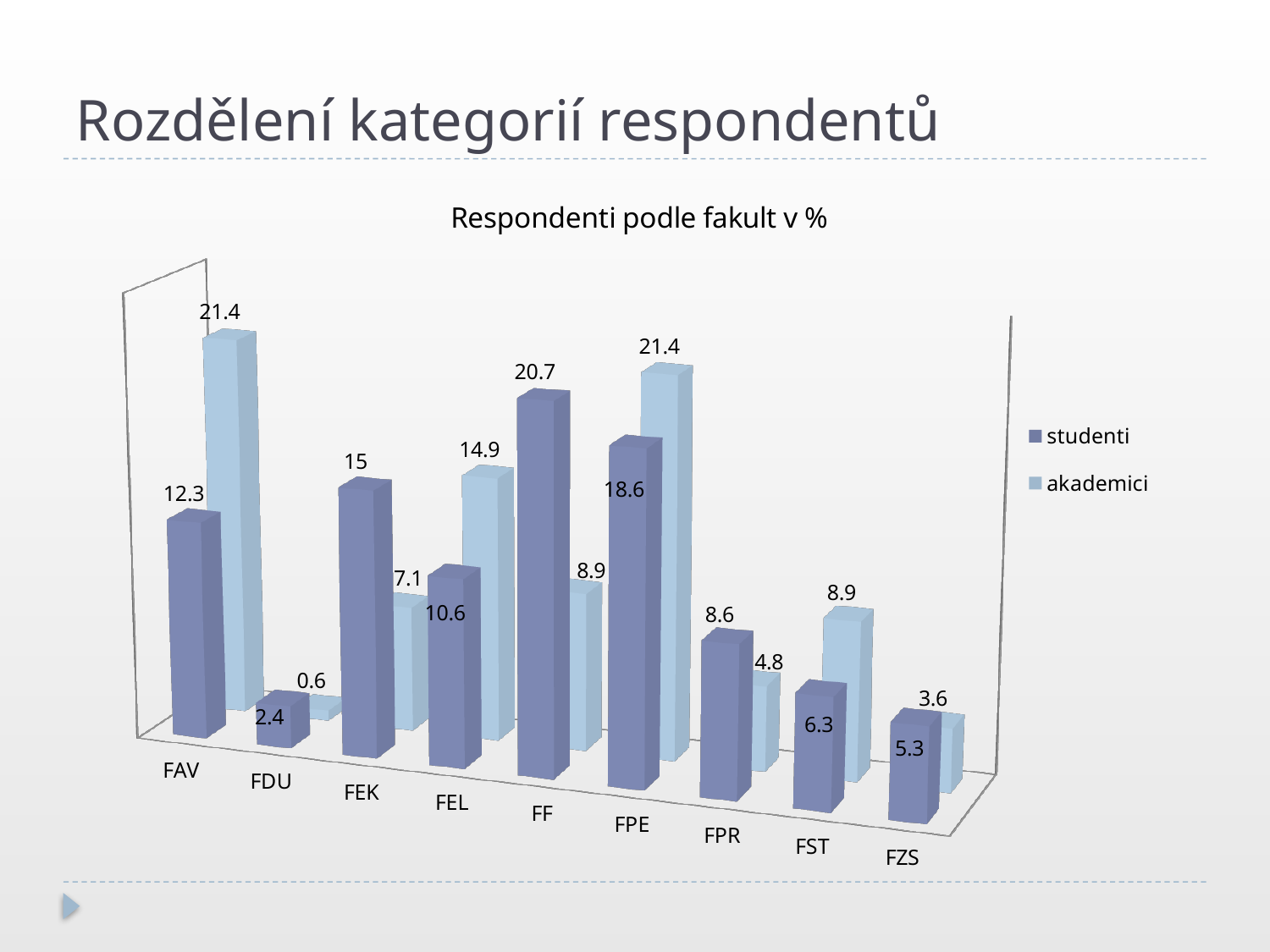
What is the studenti value for FDU? 2.4 Which is larger for FEK, the studenti value or the akademici value? studenti What is the difference between the akademici and studenti values for FAV? 9.1 What is the studenti value for FF? 20.7 What is the title of the chart? Respondenti podle fakult v % How many series does the legend list? 2 Which faculty has the highest studenti value? FF What kind of chart is shown? bar chart Which faculty has the lowest akademici value? FDU What is the akademici value for FST? 8.9 How many faculties are shown on the x axis? 9 What is the akademici value for FEL? 14.9